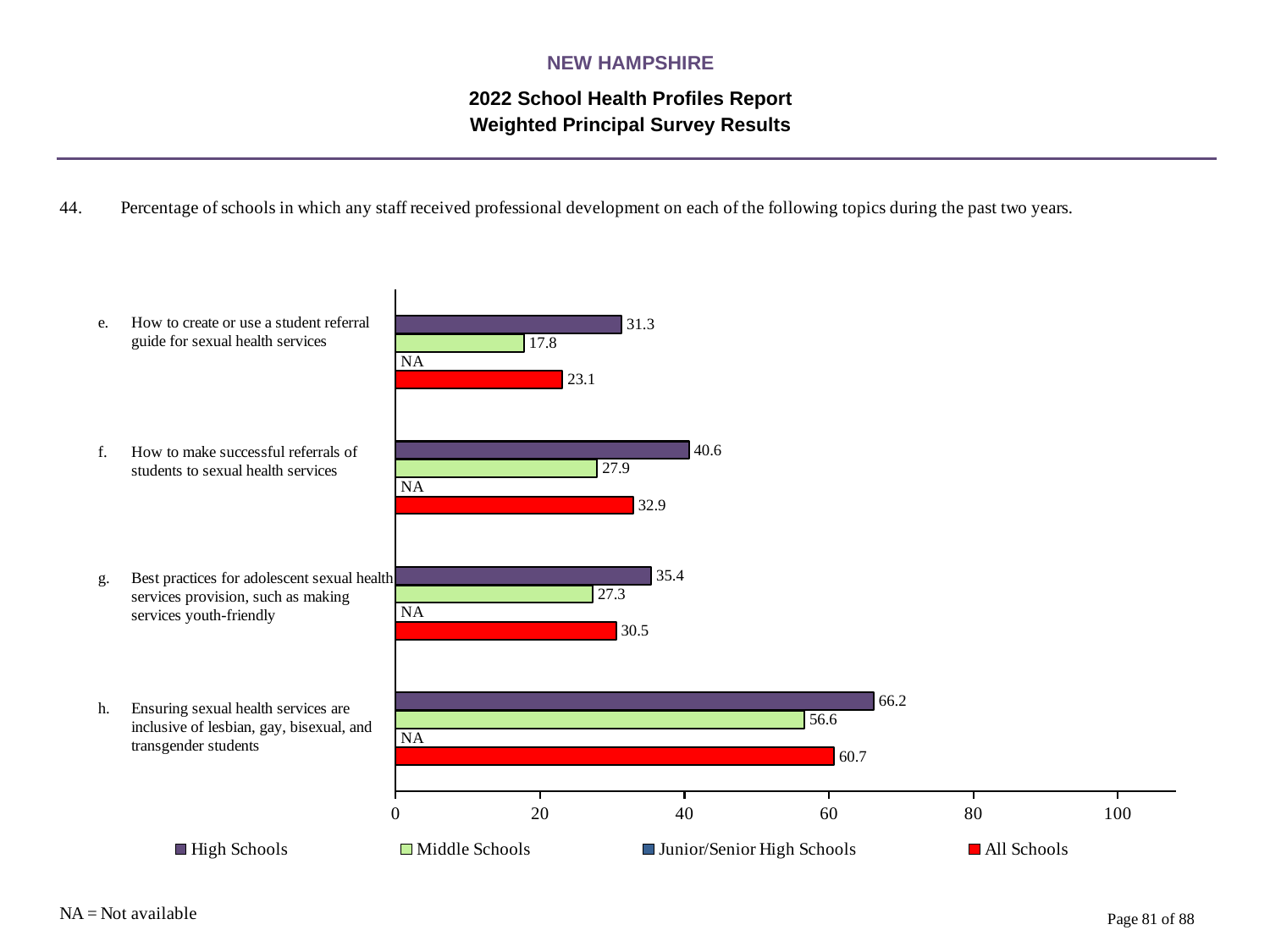
What kind of chart is shown on the slide? Bar chart How many series does the legend list? 4 For topic g, best practices for adolescent sexual health services provision, which is larger: the High Schools value or the All Schools value? High Schools What is the Junior/Senior High Schools value for topic g, best practices for adolescent sexual health services provision? NA Which topic has the highest All Schools value? h. Ensuring sexual health services are inclusive of lesbian, gay, bisexual, and transgender students What is the Middle Schools value for topic e, how to create or use a student referral guide for sexual health services? 17.8 What is the difference between the High Schools and Middle Schools values for topic f, how to make successful referrals of students to sexual health services? 12.7 What is the High Schools value for topic h, ensuring sexual health services are inclusive of lesbian, gay, bisexual, and transgender students? 66.2 Is the All Schools value for topic h, ensuring sexual health services are inclusive of LGBT students, greater or less than 60? greater How many topics (categories) are shown on the chart? 4 Which topic has the lowest Middle Schools value? e. How to create or use a student referral guide for sexual health services What is the All Schools value for topic f, how to make successful referrals of students to sexual health services? 32.9